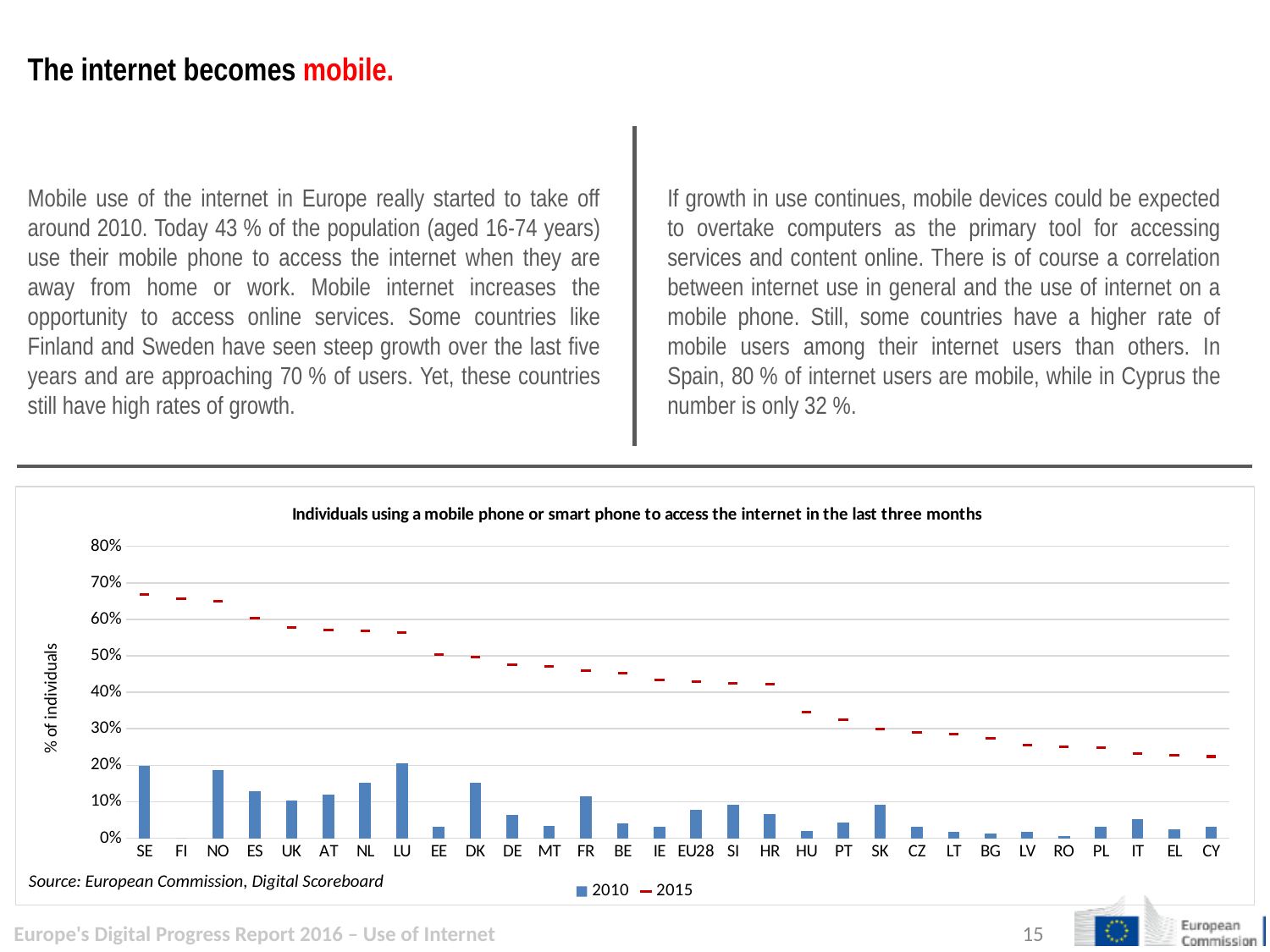
How many countries/categories are shown along the x axis of the chart? 30 Is the 2015 value for SE greater or less than 60%? greater What are the two series listed in the chart legend? 2010 and 2015 How many series does the chart legend list? 2 Which has the larger 2010 value, LU or RO? LU What is the label of the vertical axis of the chart? % of individuals Which has the larger 2015 value, SE or CY? SE Is the 2015 value for EU28 greater or less than 40%? greater Is the 2015 value for HU greater or less than 30%? greater Do the 2015 values rise or fall moving from left to right along the x axis? fall What kind of chart is shown on the slide? bar chart